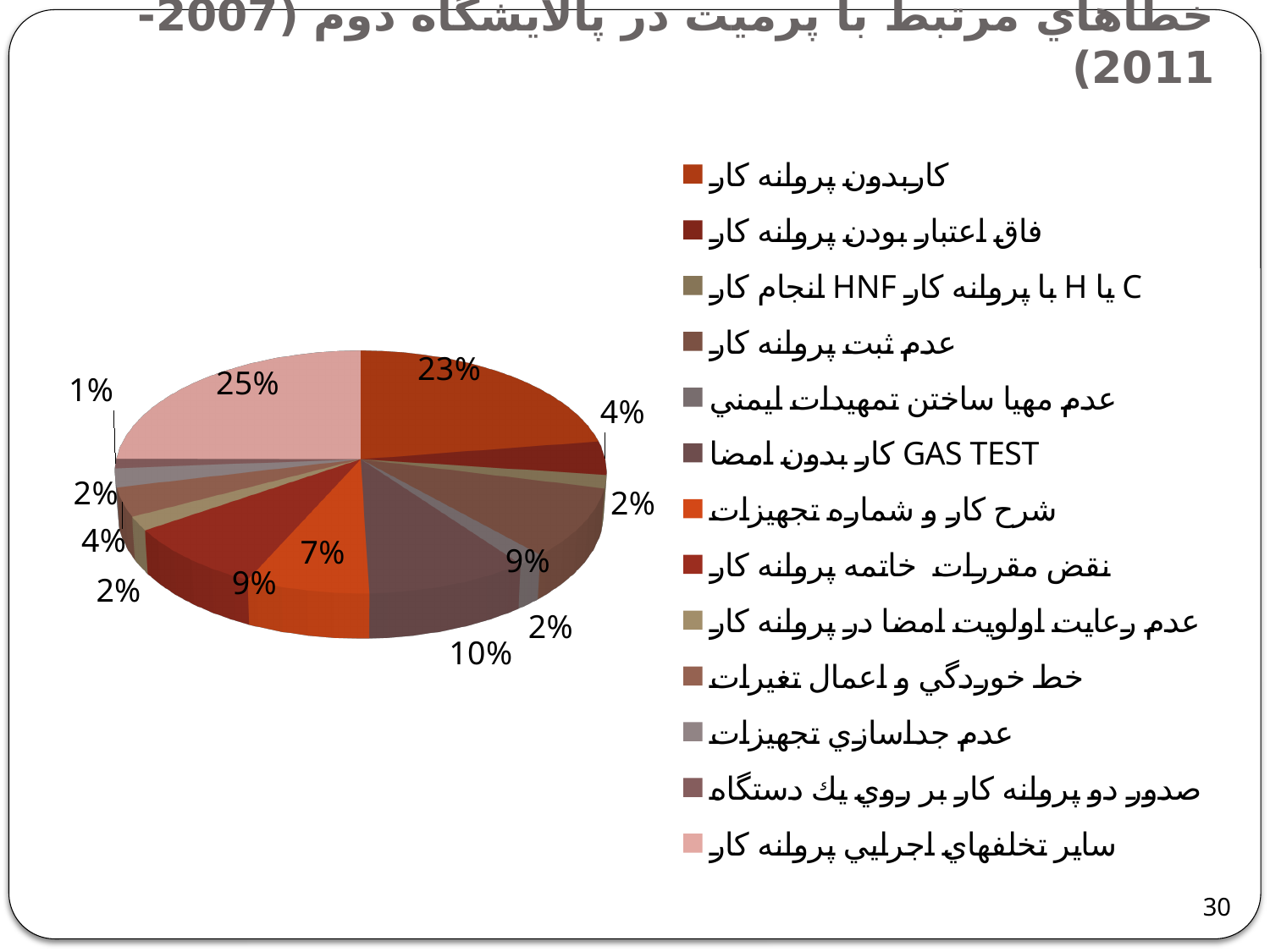
Which category has the smallest slice of the pie? صدور دو پروانه كار بر روي يك دستگاه What colour is the legend marker for "ساير تخلفهاي اجرايي پروانه كار"? light pink Which category has the largest slice of the pie? ساير تخلفهاي اجرايي پروانه كار What share of the pie does the slice for "فاقد اعتبار بودن پروانه كار" represent? 4% What share of the pie does the slice for "GAS TEST كار بدون امضا" represent? 10% What share of the pie does the slice for "شرح كار و شماره تجهيزات" (the bright orange slice) represent? 7% How many slices (categories) does the pie chart have? 13 What is the difference in percentage points between the largest slice (25%) and the slice for "كار بدون پروانه كار" (23%)? 2 Which is larger: the slice for "GAS TEST كار بدون امضا" or the slice for "شرح كار و شماره تجهيزات"? GAS TEST كار بدون امضا What kind of chart is shown on the slide? pie chart